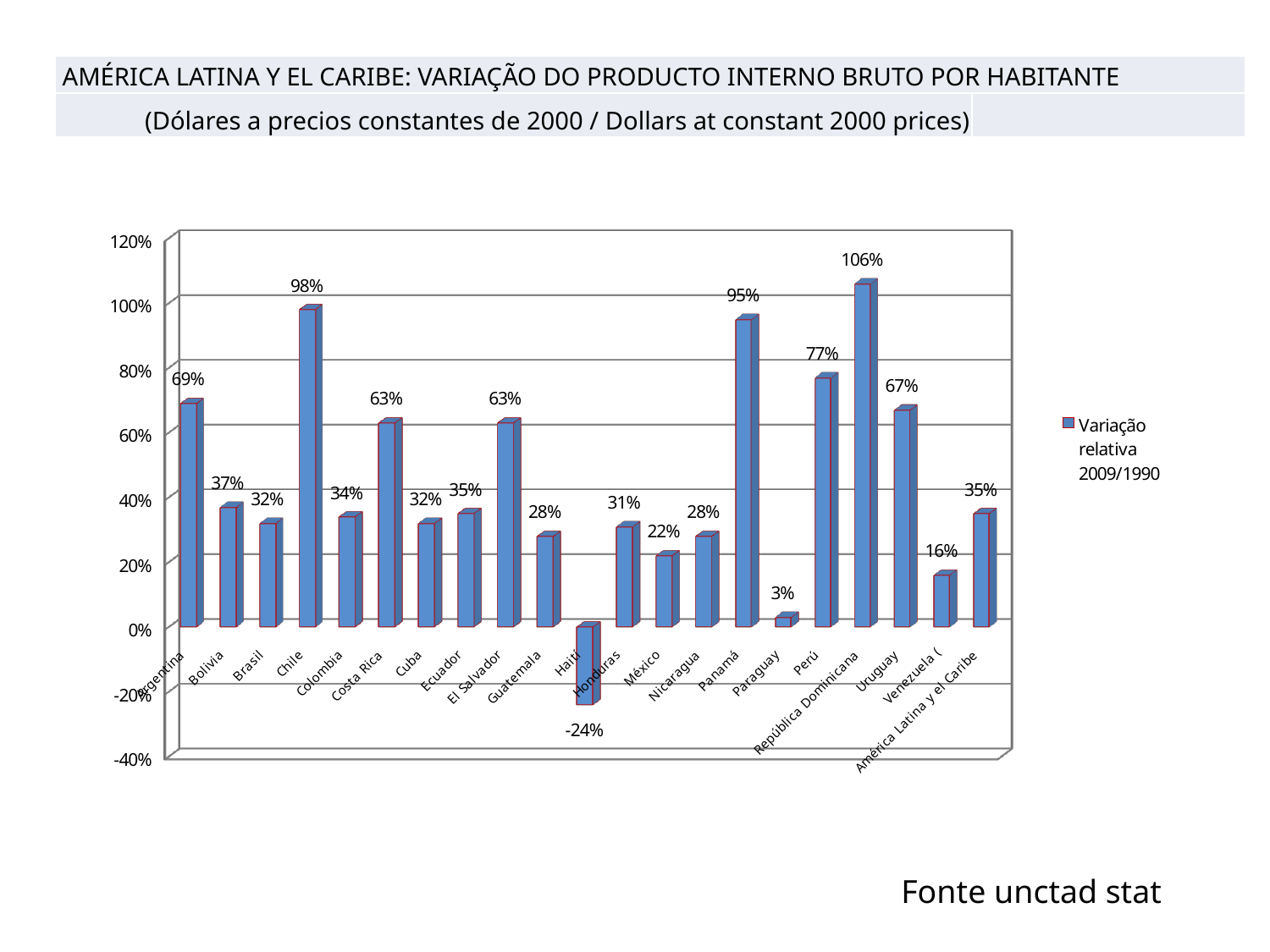
What is the value for Paraguay? 3% How many categories are shown on the x axis? 21 Which is larger, the value for Argentina or the value for Uruguay? Argentina What is the legend entry for the series? Variação relativa 2009/1990 What is the value for Chile? 98% What is the difference between the values for Panamá and Perú? 18% Which category has the highest value? República Dominicana How many series does the legend list? 1 What is the value for América Latina y el Caribe? 35% Which category has the lowest value? Haití What kind of chart is shown on the slide? Bar chart What is the value for Haití? -24%